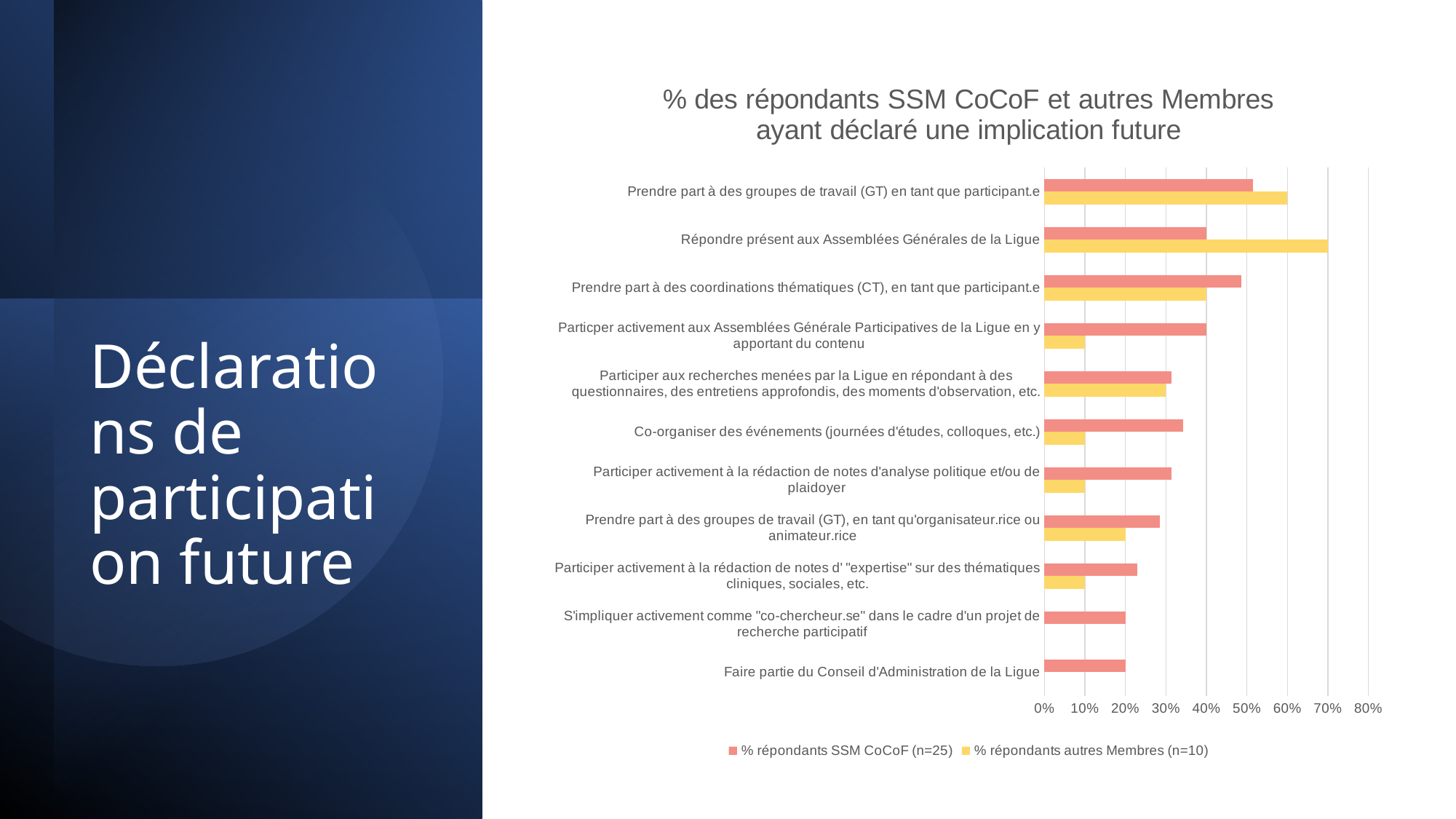
How many series does the legend list? 2 Is the value for '% répondants SSM CoCoF (n=25)' for 'Prendre part à des coordinations thématiques (CT), en tant que participant.e' greater or less than 40%? greater What is the title of the chart? % des répondants SSM CoCoF et autres Membres ayant déclaré une implication future Which category has the highest value for '% répondants autres Membres (n=10)'? Répondre présent aux Assemblées Générales de la Ligue What is the value for '% répondants autres Membres (n=10)' for 'Répondre présent aux Assemblées Générales de la Ligue'? 70% What kind of chart is shown on the slide? bar chart How many categories are plotted on the chart? 11 For 'Participer activement aux Assemblées Générale Participatives de la Ligue en y apportant du contenu', which series has the larger value? % répondants SSM CoCoF (n=25) Is the value for '% répondants SSM CoCoF (n=25)' for 'Co-organiser des événements (journées d'études, colloques, etc.)' greater or less than 40%? less Which category has the highest value for '% répondants SSM CoCoF (n=25)'? Prendre part à des groupes de travail (GT) en tant que participant.e What is the value for '% répondants SSM CoCoF (n=25)' for 'Faire partie du Conseil d'Administration de la Ligue'? 20% What is the value for '% répondants autres Membres (n=10)' for 'Prendre part à des groupes de travail (GT) en tant que participant.e'? 60%